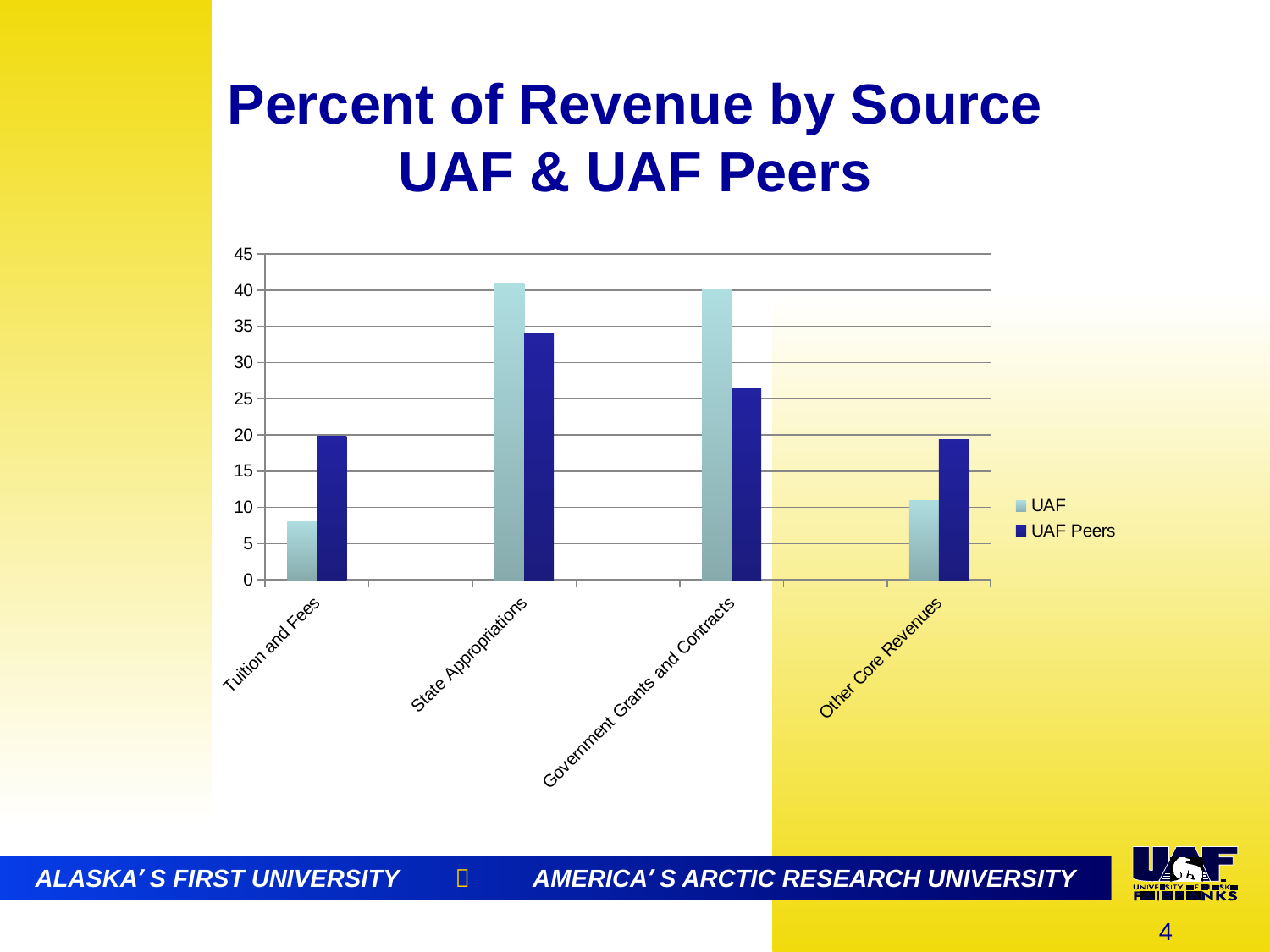
How many series does the legend list? 2 How many revenue source categories are shown on the x axis? 4 What is the title of the chart on the slide? Percent of Revenue by Source UAF & UAF Peers Which category has the highest value for UAF Peers? State Appropriations Which category has the lowest value for UAF? Tuition and Fees For Tuition and Fees, which is larger, UAF or UAF Peers? UAF Peers For Government Grants and Contracts, which is larger, UAF or UAF Peers? UAF What kind of chart is shown on the slide? bar chart Is the UAF Peers value for Government Grants and Contracts greater or less than 30? less Is the UAF value for State Appropriations greater or less than 35? greater Is the UAF value for Tuition and Fees greater or less than 10? less